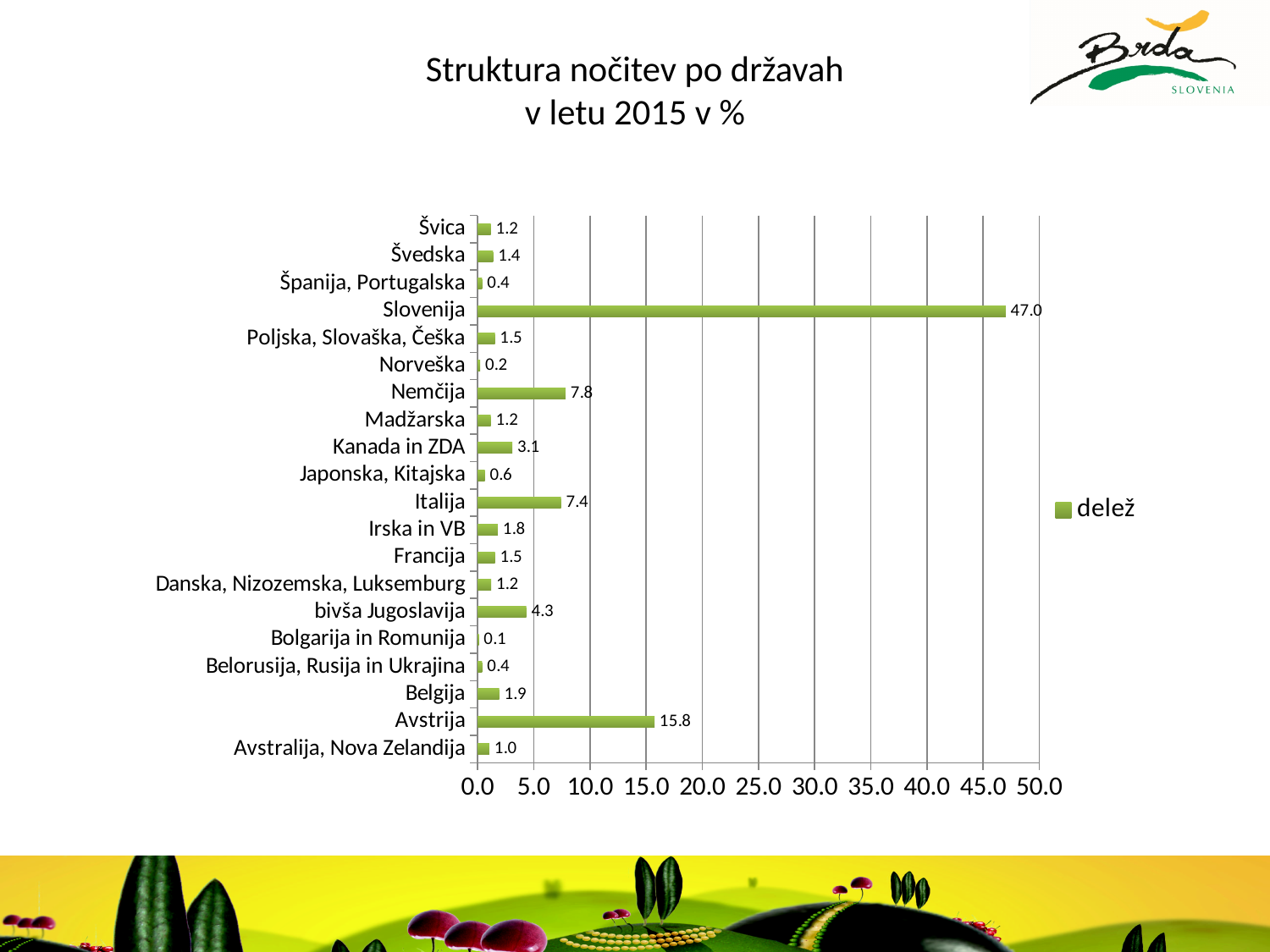
What is the difference between the values for Slovenija and Avstrija? 31.2 What is the value for bivša Jugoslavija? 4.3 What is the value for Slovenija? 47.0 Which category has the lowest share? Bolgarija in Romunija Which country has the highest share? Slovenija What is the value for Avstrija? 15.8 What kind of chart is shown on the slide? bar chart What is the value for Nemčija? 7.8 What is the legend entry of the chart? delež Which is larger, the value for Nemčija or the value for Italija? Nemčija How many categories are shown on the chart? 20 Is the value for Avstrija greater or less than 20.0? less